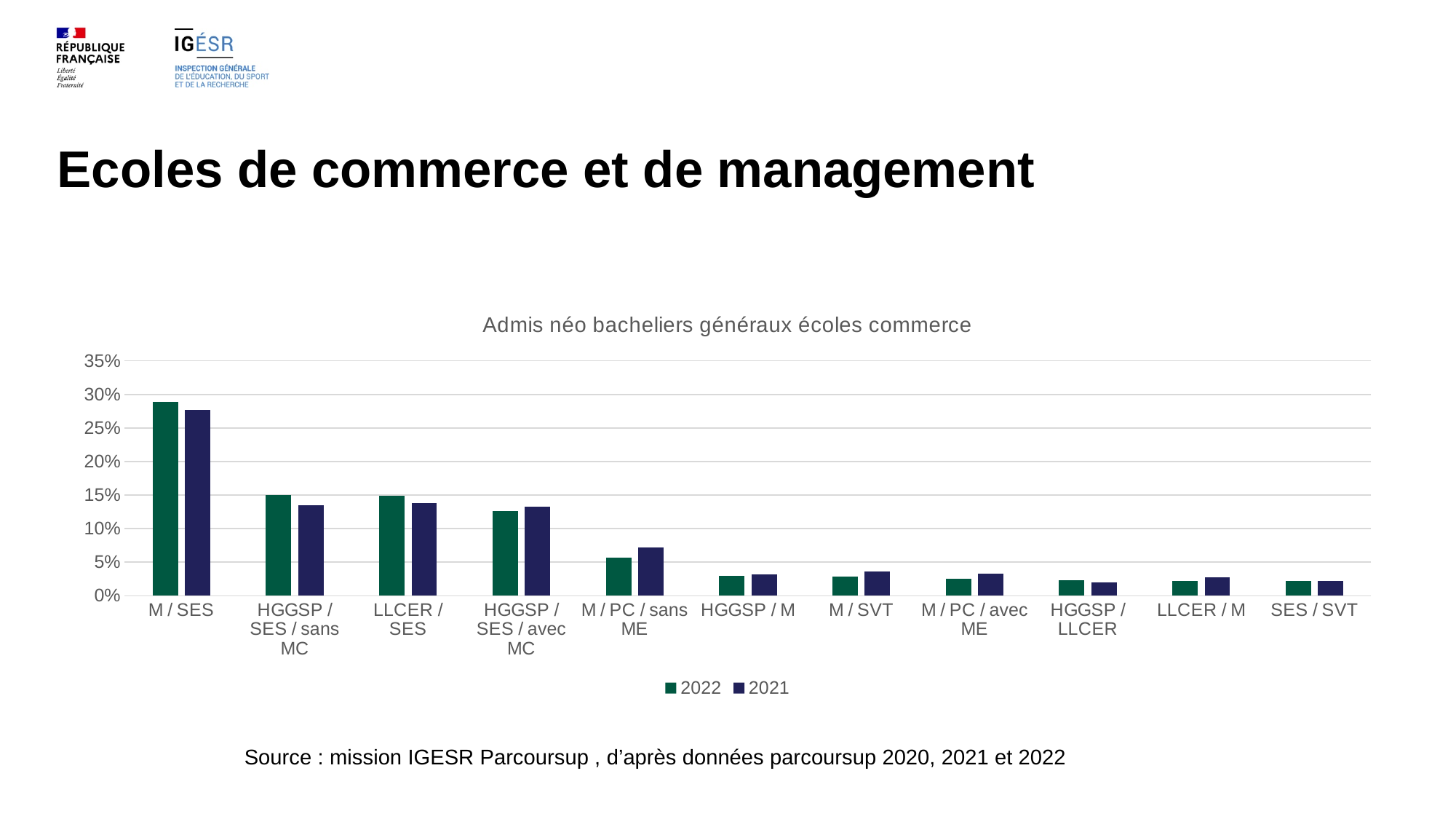
Is the 2022 value for HGGSP / SES / avec MC greater or less than 15%? less What is the title of the chart? Admis néo bacheliers généraux écoles commerce What kind of chart is shown on the slide? bar chart For M / PC / sans ME, which series has the larger value, 2022 or 2021? 2021 Is the 2022 value for M / SES greater or less than 25%? greater Is the 2021 value for M / PC / sans ME greater or less than 5%? greater How many categories are shown on the x axis? 11 For HGGSP / SES / sans MC, which series has the larger value, 2022 or 2021? 2022 Which category has the highest value for 2022? M / SES Which category has the highest value for 2021? M / SES Do the 2022 values generally rise or fall from left to right along the x axis? fall How many series does the legend list? 2